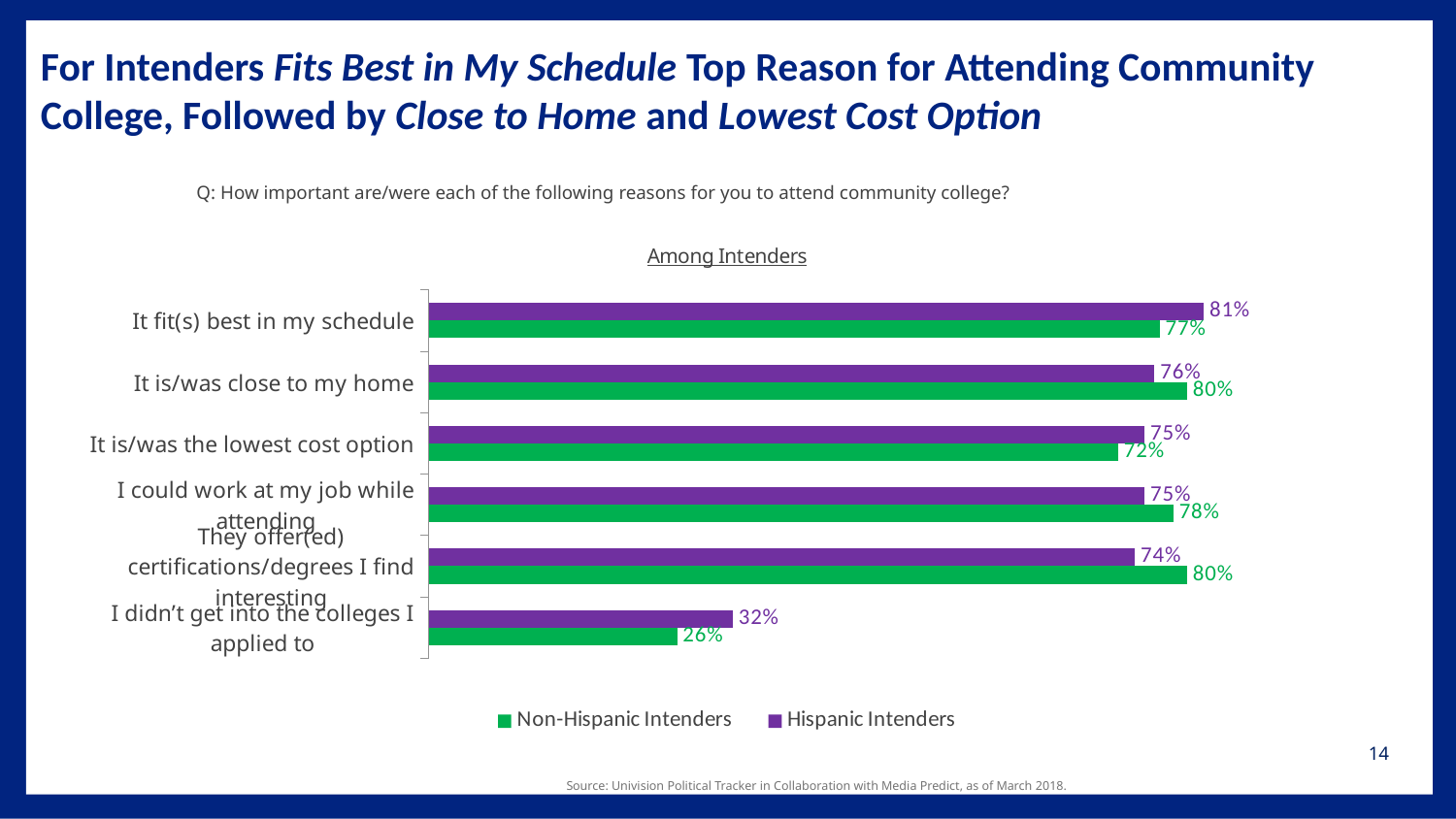
What is the value for Non-Hispanic Intenders for "I didn't get into the colleges I applied to"? 26% How many reasons (categories) are shown in the chart? 6 What is the value for Hispanic Intenders for "They offer(ed) certifications/degrees I find interesting"? 74% What percentage of Non-Hispanic Intenders said "It is/was close to my home" was important? 80% What is the difference between Hispanic and Non-Hispanic Intenders for "I didn't get into the colleges I applied to"? 6 percentage points What type of chart is shown on the slide? Bar chart Which reason has the lowest value among Non-Hispanic Intenders? I didn't get into the colleges I applied to For "It is/was the lowest cost option", which group has the higher value, Hispanic Intenders or Non-Hispanic Intenders? Hispanic Intenders Which reason has the highest value among Hispanic Intenders? It fit(s) best in my schedule How many series does the legend list? 2 For "I could work at my job while attending", which group has the higher value? Non-Hispanic Intenders What percentage of Hispanic Intenders said "It fit(s) best in my schedule" was important? 81%